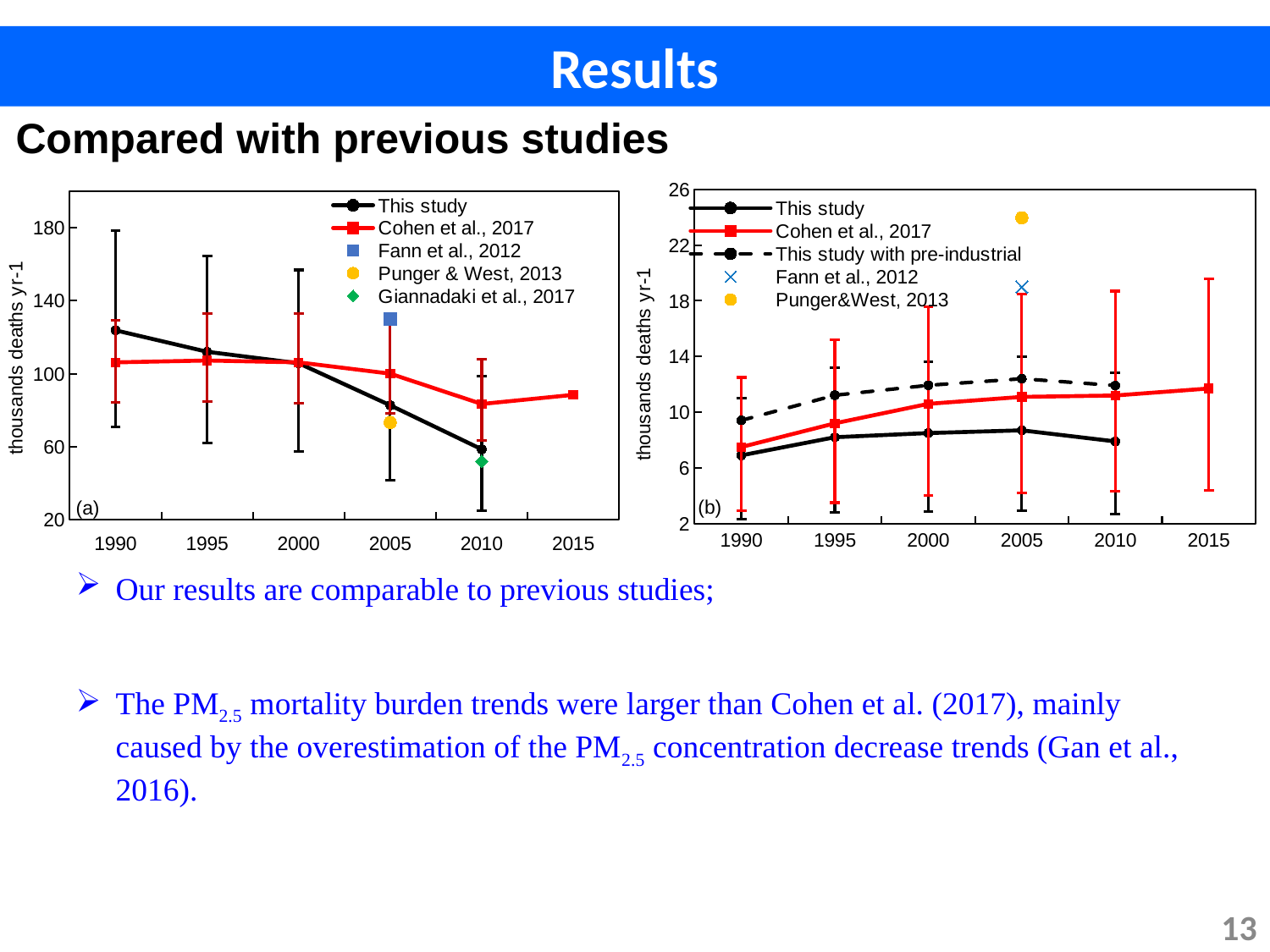
In chart (a) on the left, which is larger in 2010: This study or Cohen et al., 2017? Cohen et al., 2017 In chart (a) on the left, how many entries does the legend list? 5 In chart (a) on the left, is the value for This study in 2010 greater or less than 100? less In chart (a) on the left, does the This study line rise or fall from 1990 to 2010? fall In chart (a) on the left, is the value for Fann et al., 2012 greater or less than 100? greater In chart (a) on the left, how many data points does the Cohen et al., 2017 line have? 6 What kind of chart is chart (a) on the left? line chart In chart (b) on the right, how many entries does the legend list? 5 In chart (b) on the right, is the value for Punger&West, 2013 greater or less than 22? greater In chart (b) on the right, which is larger in 2005: This study or This study with pre-industrial? This study with pre-industrial